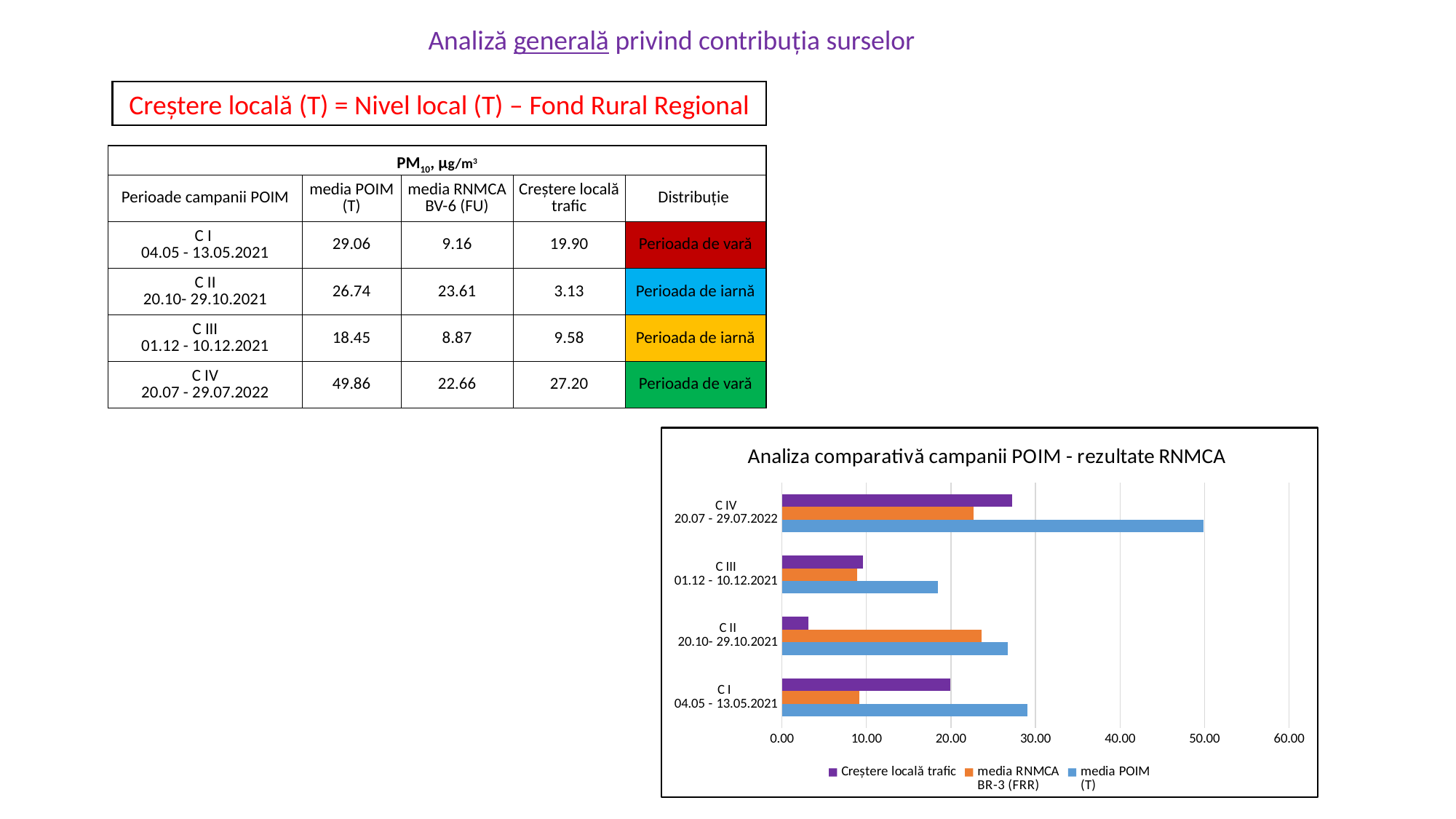
Is the value for media POIM (T) in C III 01.12 - 10.12.2021 greater or less than 20.00? less What kind of chart is shown on the slide? bar chart How many campaign periods are plotted on the chart? 4 Which campaign period has the highest value for media POIM (T) on the chart? C IV 20.07 - 29.07.2022 Which is larger: media POIM (T) for C I 04.05 - 13.05.2021 or for C III 01.12 - 10.12.2021? C I 04.05 - 13.05.2021 How many series does the legend of the chart list? 3 Which campaign period has the lowest value for Creștere locală trafic on the chart? C II 20.10- 29.10.2021 Is the value for Creștere locală trafic in C II 20.10- 29.10.2021 greater or less than 10.00? less In C II 20.10- 29.10.2021, which is larger: media RNMCA BR-3 (FRR) or Creștere locală trafic? media RNMCA BR-3 (FRR) Is the value for media POIM (T) in C IV 20.07 - 29.07.2022 greater or less than 40.00? greater What colour are the bars for media POIM (T) in the chart? blue What is the title of the chart? Analiza comparativă campanii POIM - rezultate RNMCA